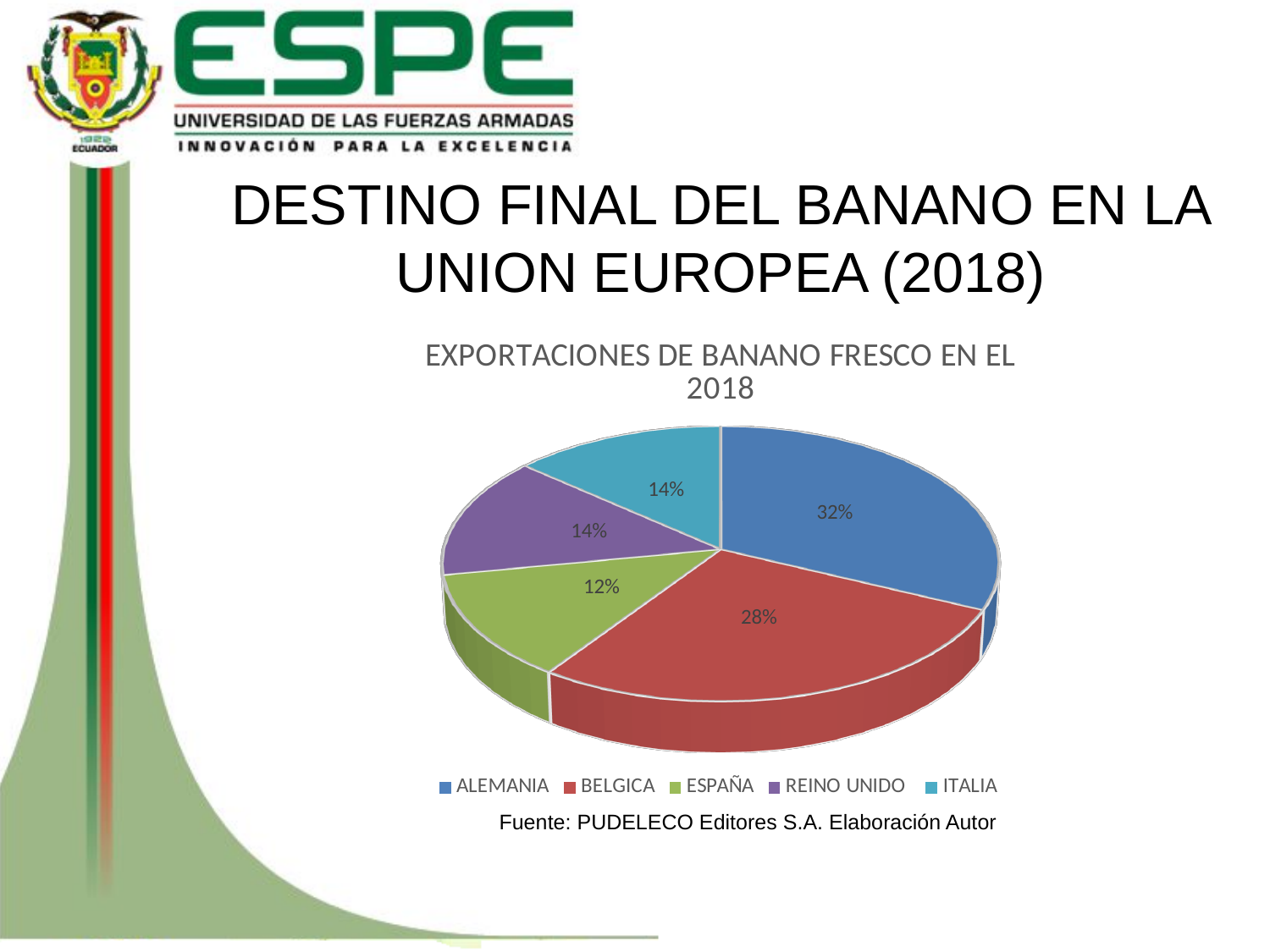
Which country has the largest slice of the pie? ALEMANIA What type of chart is shown on the slide? Pie chart What is the title of the chart? EXPORTACIONES DE BANANO FRESCO EN EL 2018 What is the difference in percentage points between ALEMANIA and BELGICA? 4 Which country has the smallest slice of the pie? ESPAÑA What share of the pie does ITALIA hold? 14% What share of the pie does REINO UNIDO hold? 14% How many countries are shown in the pie chart legend? 5 What share of the pie does ALEMANIA hold? 32% Which is larger, the share for BELGICA or the share for ESPAÑA? BELGICA